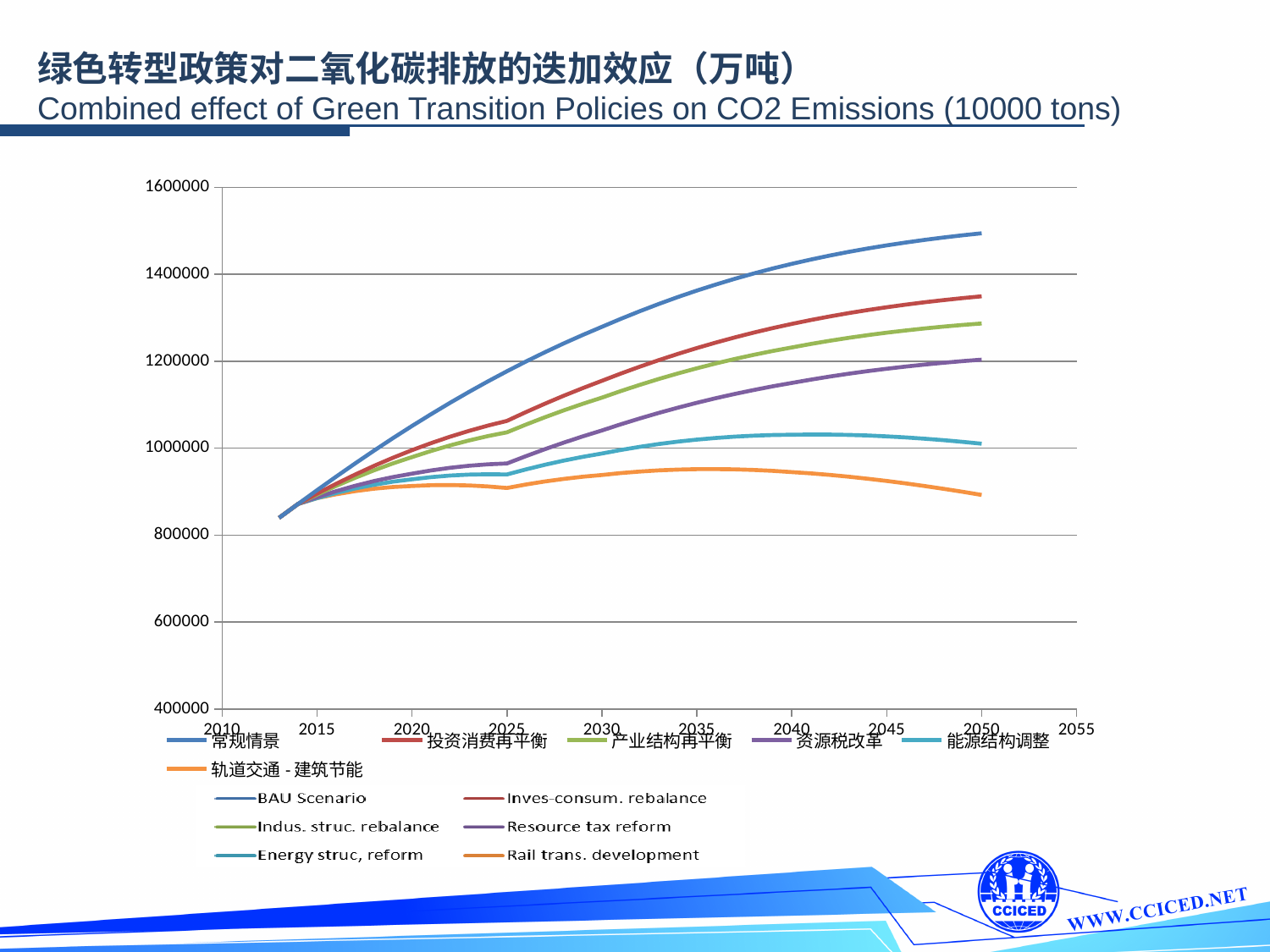
In 2050, which is larger: Inves-consum. rebalance or Indus. struc. rebalance? Inves-consum. rebalance Which series has the lowest value in 2050? Rail trans. development Is the value for BAU Scenario in 2050 greater or less than 1400000? greater Which series has the highest value in 2050? BAU Scenario What kind of chart is shown on the slide? line chart Is the value for Inves-consum. rebalance in 2050 greater or less than 1400000? less Does the BAU Scenario line rise or fall from 2010 to 2050? rise Does the Rail trans. development line rise or fall between 2035 and 2050? fall Is the value for Indus. struc. rebalance in 2050 greater or less than 1200000? greater How many series does the legend list? 6 What is the English title of the chart on the slide? Combined effect of Green Transition Policies on CO2 Emissions (10000 tons)